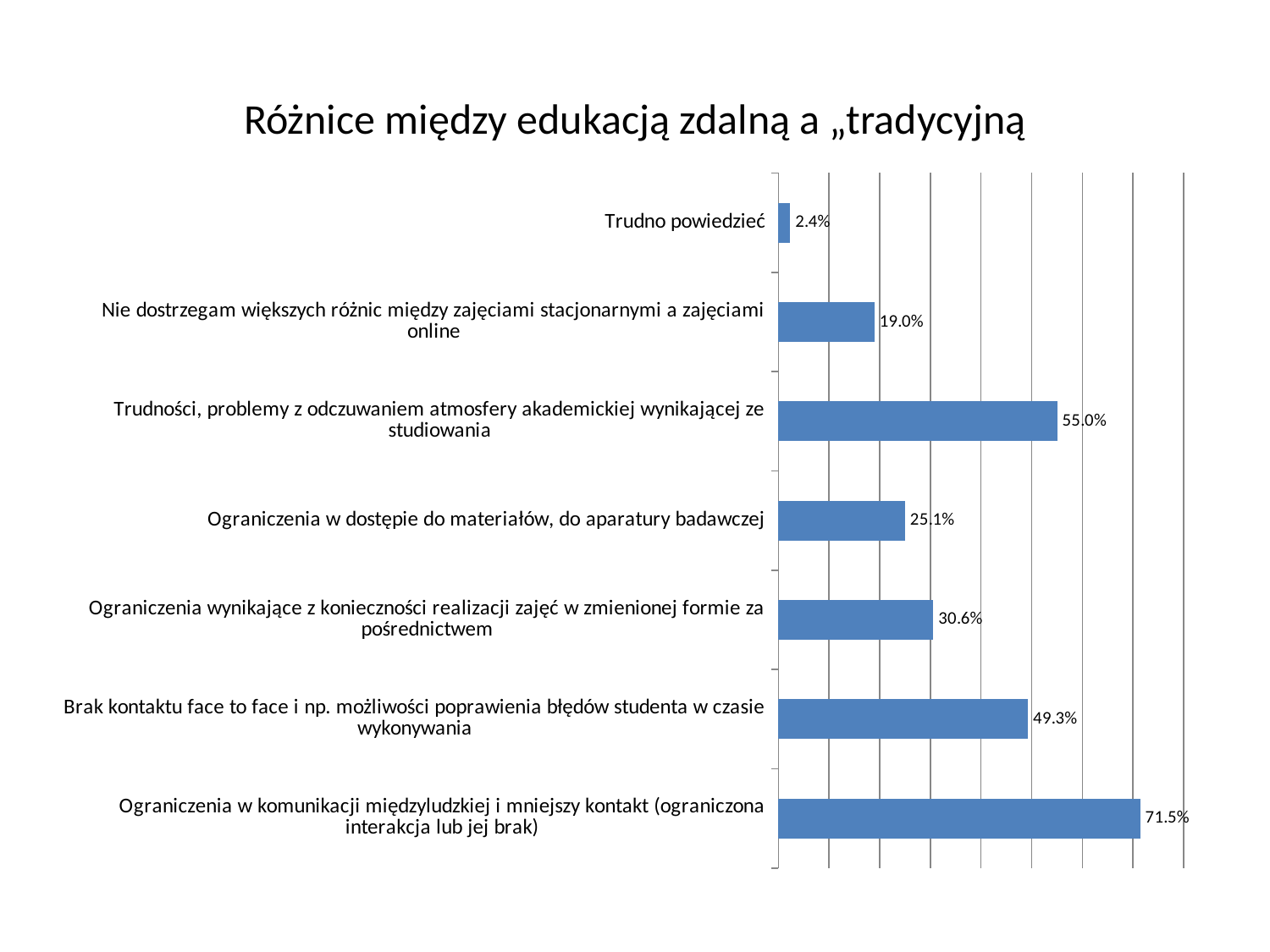
What is the title of the chart? Różnice między edukacją zdalną a „tradycyjną What kind of chart is shown on the slide? Bar chart What is the difference between the value for "Ograniczenia w komunikacji międzyludzkiej i mniejszy kontakt" and the value for "Trudności, problemy z odczuwaniem atmosfery akademickiej wynikającej ze studiowania"? 16.5% Which category has the highest value? Ograniczenia w komunikacji międzyludzkiej i mniejszy kontakt (ograniczona interakcja lub jej brak) What is the difference between the value for "Ograniczenia wynikające z konieczności realizacji zajęć w zmienionej formie za pośrednictwem" and the value for "Ograniczenia w dostępie do materiałów, do aparatury badawczej"? 5.5% Which category has the lowest value? Trudno powiedzieć What is the value for "Ograniczenia w dostępie do materiałów, do aparatury badawczej"? 25.1% What is the value for "Trudno powiedzieć"? 2.4% What is the value for "Nie dostrzegam większych różnic między zajęciami stacjonarnymi a zajęciami online"? 19.0% Which is larger: the value for "Trudności, problemy z odczuwaniem atmosfery akademickiej wynikającej ze studiowania" or the value for "Brak kontaktu face to face i np. możliwości poprawienia błędów studenta w czasie wykonywania"? Trudności, problemy z odczuwaniem atmosfery akademickiej wynikającej ze studiowania How many categories are shown in the chart? 7 What is the value for "Brak kontaktu face to face i np. możliwości poprawienia błędów studenta w czasie wykonywania"? 49.3%